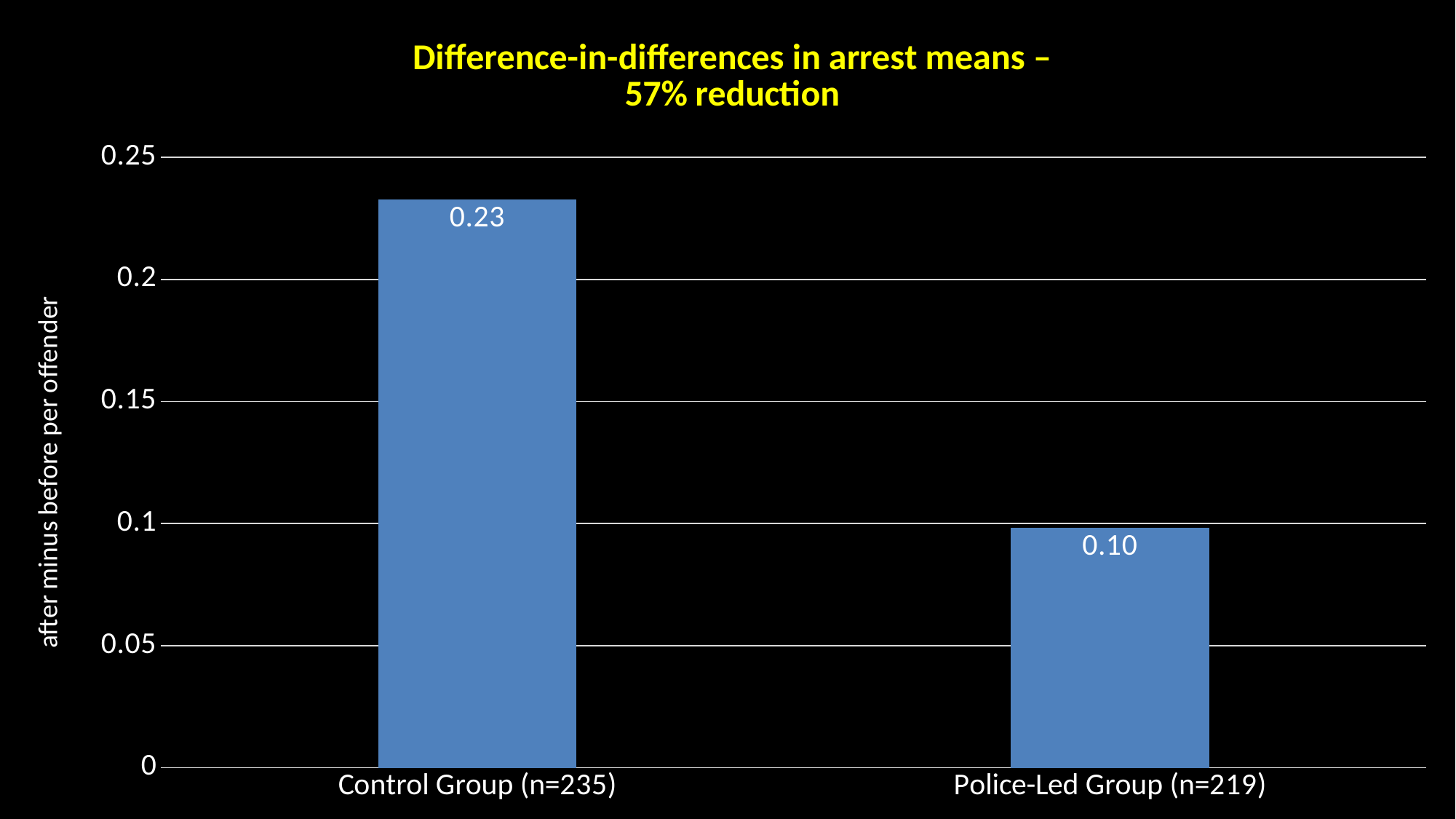
What is the difference between the Control Group value and the Police-Led Group value? 0.13 Is the value for the Police-Led Group (n=219) greater or less than 0.15? less What kind of chart is shown on the slide? Bar chart What is the value for the Control Group (n=235)? 0.23 What is the title of the chart? Difference-in-differences in arrest means – 57% reduction Which group has the lowest value? Police-Led Group (n=219) What is the label of the vertical axis? after minus before per offender Which group has the highest value? Control Group (n=235) How many groups are shown on the chart? 2 What is the value for the Police-Led Group (n=219)? 0.10 Is the value for the Control Group (n=235) greater or less than 0.2? greater Which is larger, the value for the Control Group or the value for the Police-Led Group? Control Group